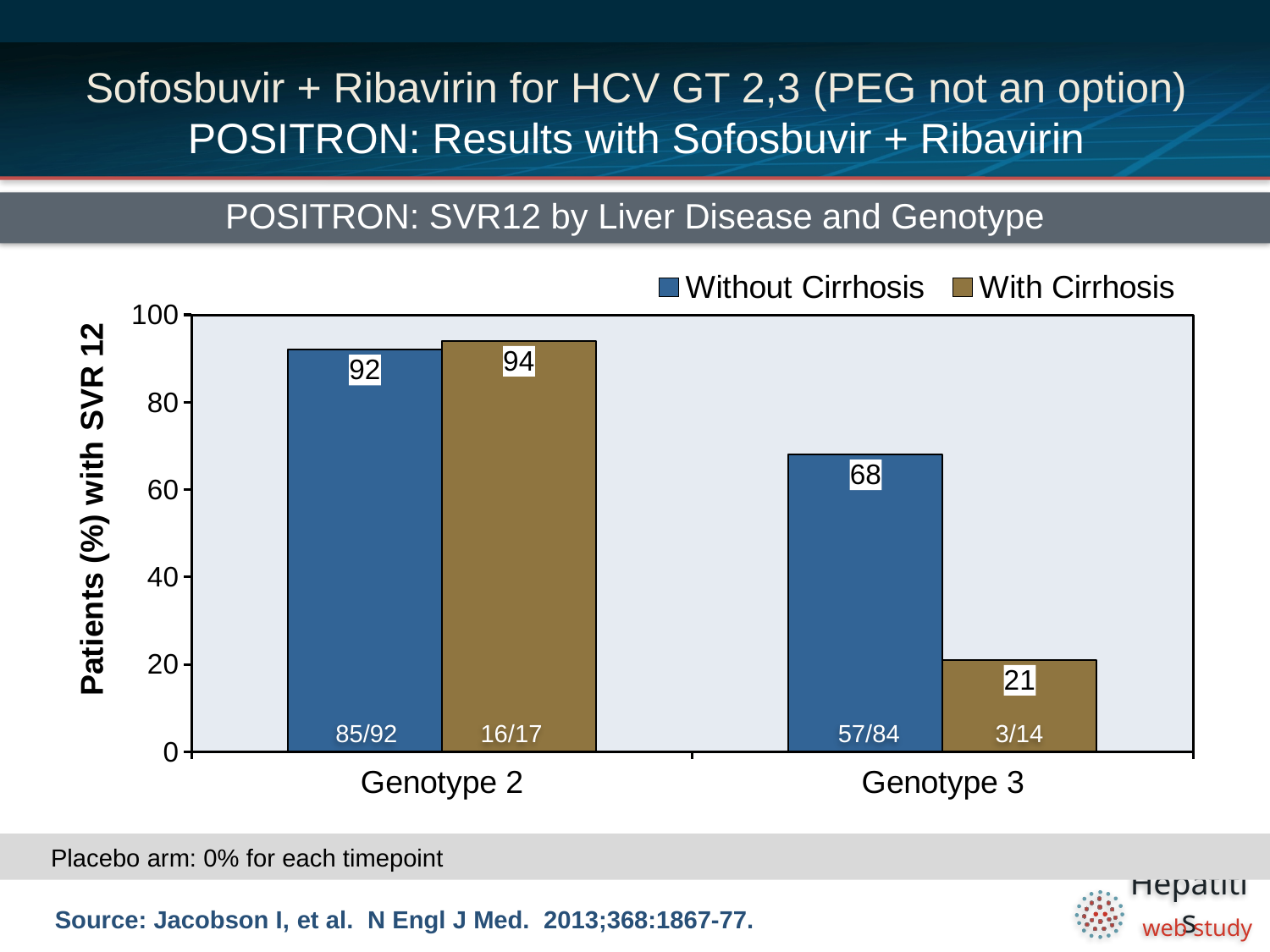
What is the difference in SVR12 rate between patients without cirrhosis and with cirrhosis in Genotype 3? 47 Which bar has the lowest SVR12 rate? Genotype 3, With Cirrhosis What kind of chart is shown on the slide? Bar chart What is the SVR12 rate for Genotype 3 patients with cirrhosis? 21 How many genotype categories are shown on the x axis? 2 For Genotype 3, which group has the higher SVR12 rate: without cirrhosis or with cirrhosis? Without Cirrhosis How many series does the legend list? 2 What is the SVR12 rate for Genotype 2 patients without cirrhosis? 92 What is the SVR12 rate for Genotype 2 patients with cirrhosis? 94 What fraction of patients is shown at the base of the Genotype 3 With Cirrhosis bar? 3/14 What is the SVR12 rate for Genotype 3 patients without cirrhosis? 68 Which bar has the highest SVR12 rate? Genotype 2, With Cirrhosis